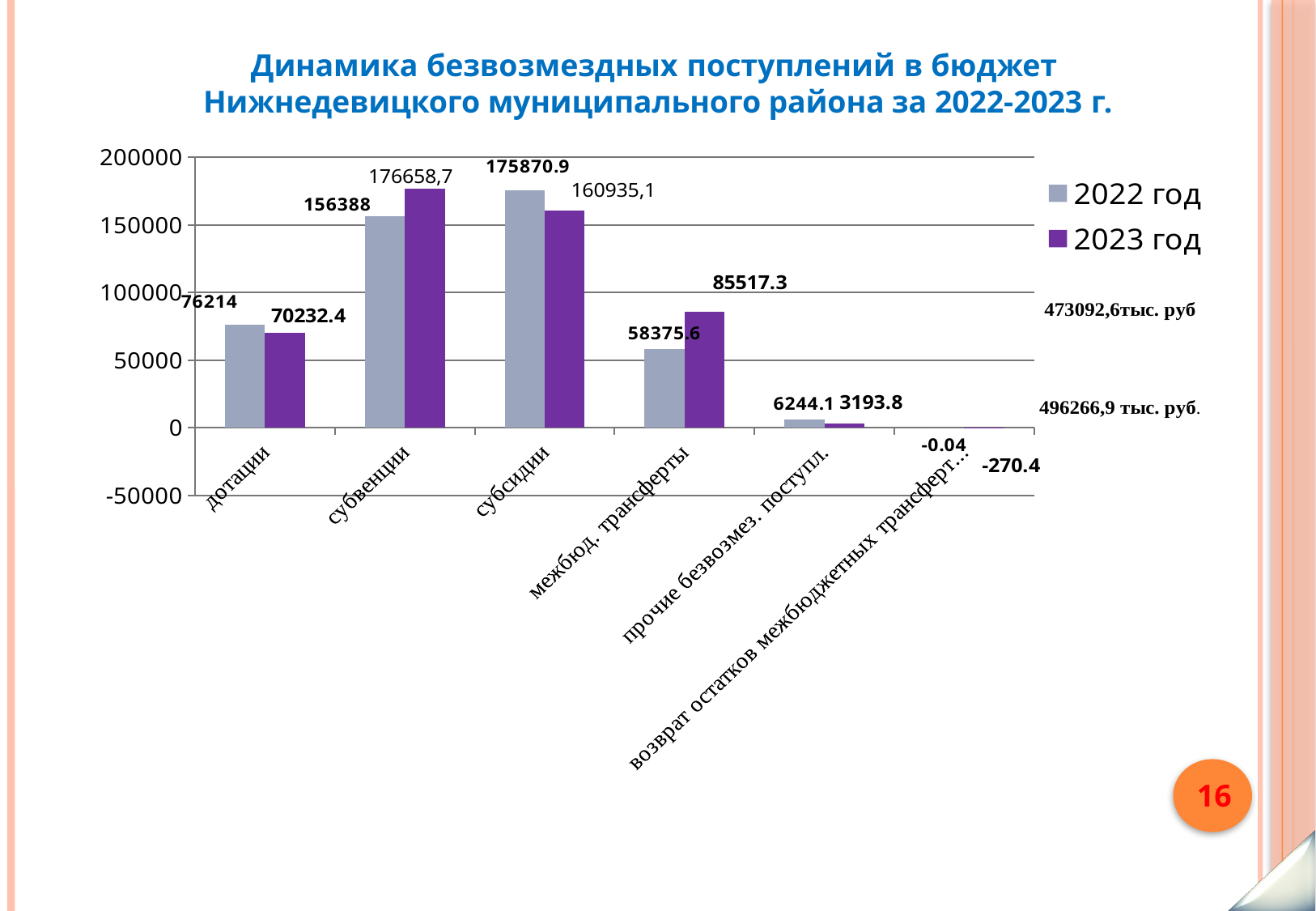
What is the value for межбюд. трансферты in 2023 год? 85517.3 What is the difference between the 2022 год and 2023 год values for дотации? 5981.6 What is the value for субвенции in 2023 год? 176658,7 What is the value for дотации in 2022 год? 76214 Which category has the highest value in the 2022 год series? субсидии What type of chart is shown on the slide? Bar chart How many categories are shown on the x axis? 6 How many series does the legend list? 2 Which category has the highest value in the 2023 год series? субвенции What is the difference between the 2023 год and 2022 год values for межбюд. трансферты? 27141.7 What is the value for прочие безвозмез. поступл. in 2022 год? 6244.1 Which is larger for субсидии: the 2022 год value or the 2023 год value? 2022 год